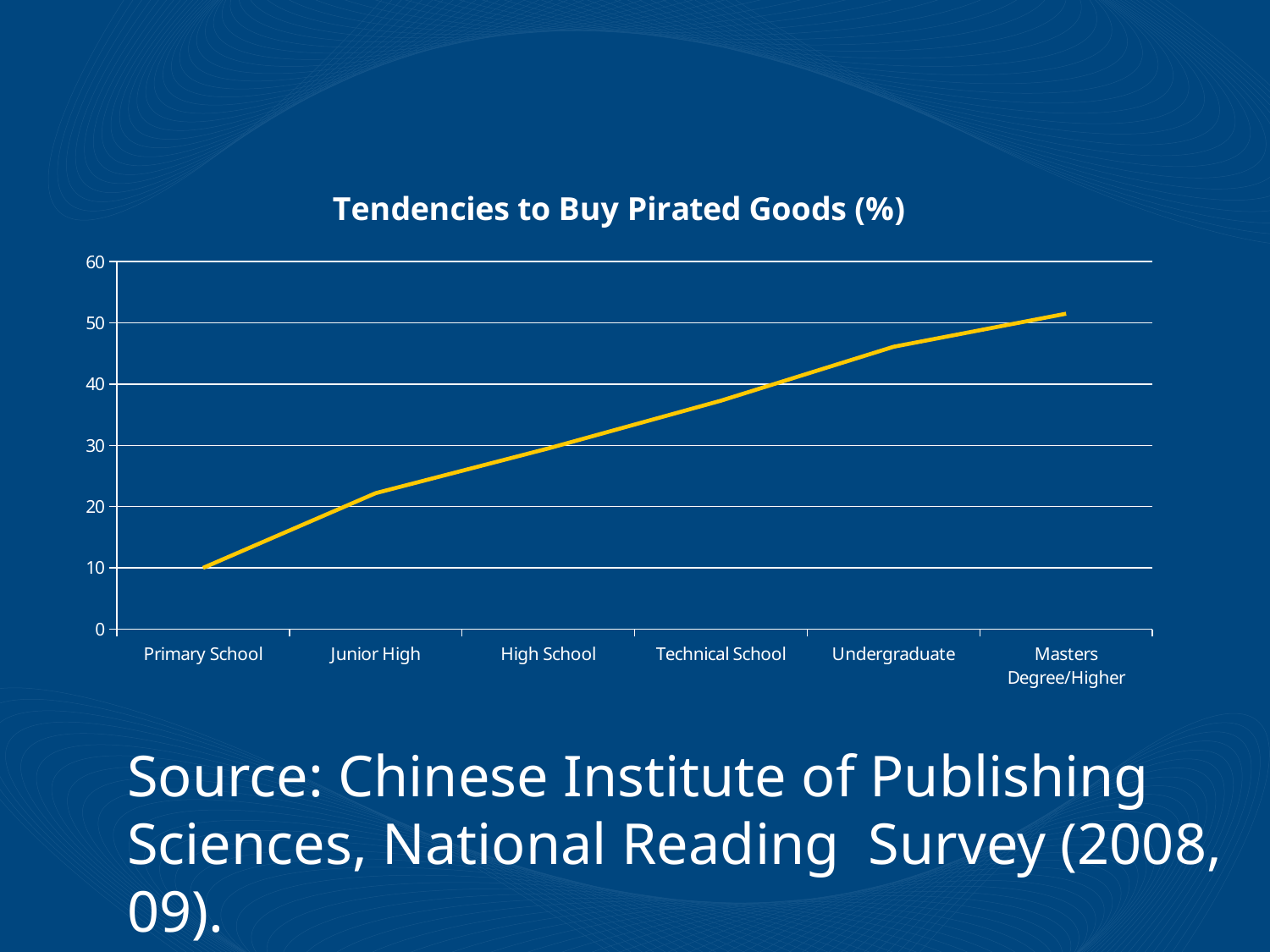
Which is larger, the value for Technical School or the value for High School? Technical School What kind of chart is shown on the slide? line chart Is the value for Junior High greater or less than 20? greater Which category has the highest tendency to buy pirated goods? Masters Degree/Higher How many education categories are plotted along the x axis? 6 Is the value for Primary School greater or less than 20? less What is the title of the chart? Tendencies to Buy Pirated Goods (%) Is the value for Undergraduate greater or less than 50? less Which category has the lowest tendency to buy pirated goods? Primary School Do the values rise or fall as education level increases along the x axis? rise What is the maximum value shown on the y axis? 60